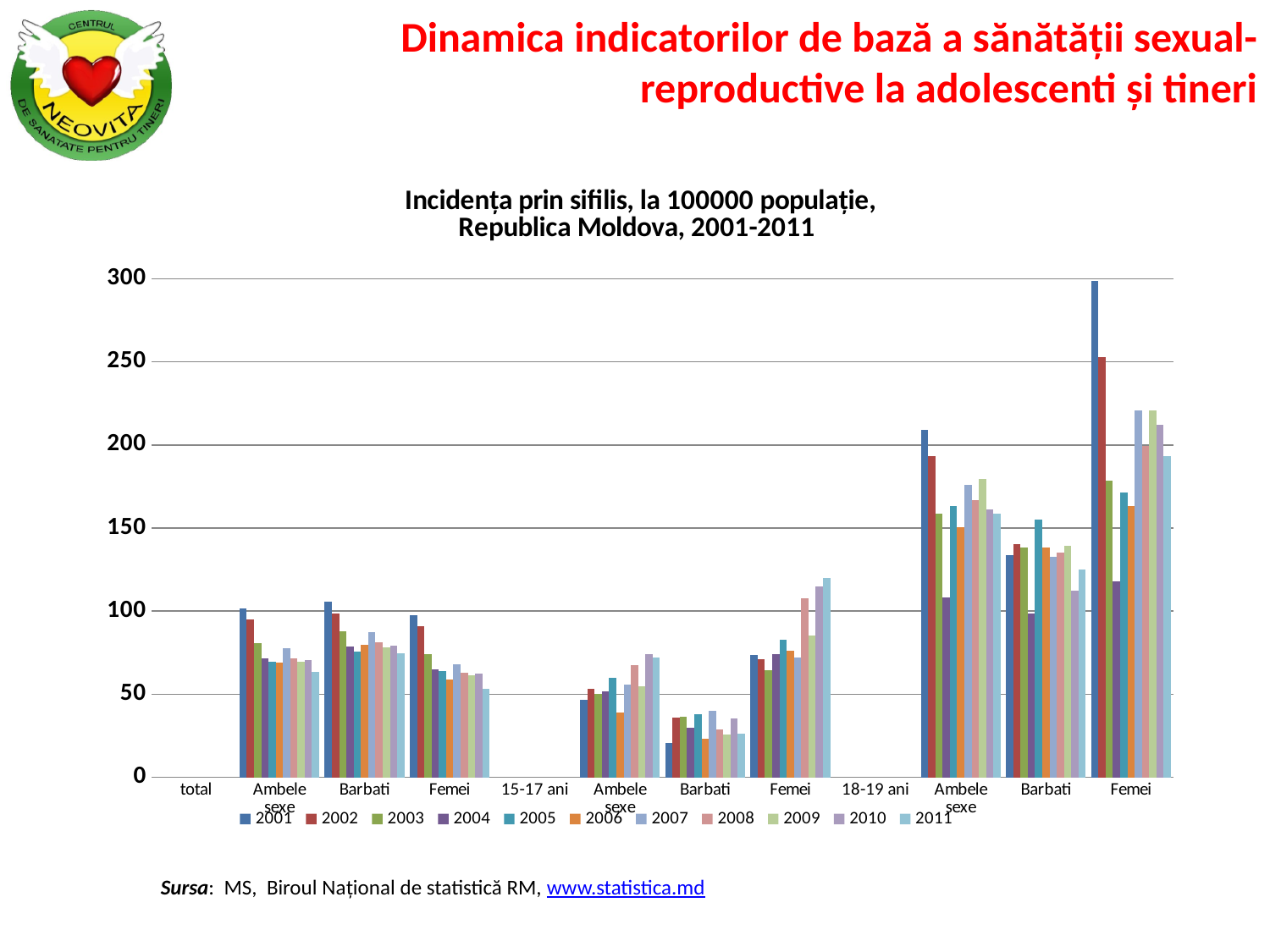
What kind of chart is shown on the slide? bar chart How many series does the legend list? 11 In the 15-17 ani group, is the 2011 value for Femei greater or less than 100? greater In the 18-19 ani group, is the 2001 value for Ambele sexe greater or less than 200? greater In the 18-19 ani group, which year has the highest value for Femei? 2001 In the 15-17 ani group, is the 2001 value for Barbati greater or less than 50? less In the 15-17 ani group, which year has the lowest value for Barbati? 2001 Which years are listed first and last in the legend? 2001 and 2011 In the 15-17 ani group, which is larger for Femei: the 2001 value or the 2011 value? 2011 What is the title of the chart? Incidența prin sifilis, la 100000 populație, Republica Moldova, 2001-2011 In the total group, do the values for Ambele sexe generally rise or fall from 2001 to 2011? fall